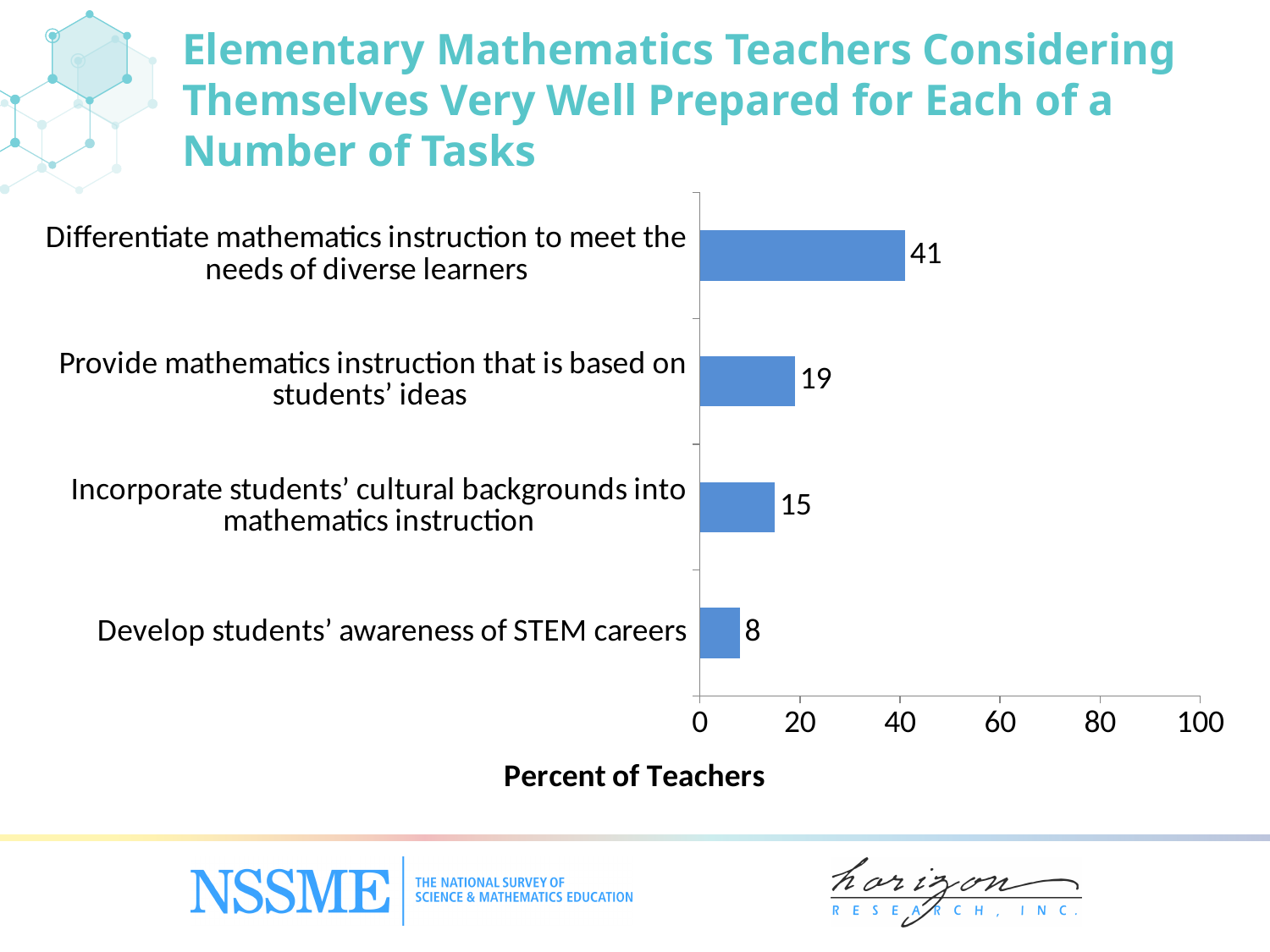
How many tasks are shown in the chart? 4 What is the difference between the value for differentiating mathematics instruction and the value for developing students' awareness of STEM careers? 33 Which task has the lowest percent of teachers considering themselves very well prepared? Develop students' awareness of STEM careers What is the value for incorporating students' cultural backgrounds into mathematics instruction? 15 What is the label of the horizontal axis? Percent of Teachers Which task has the highest percent of teachers considering themselves very well prepared? Differentiate mathematics instruction to meet the needs of diverse learners What is the difference between the value for providing instruction based on students' ideas and the value for incorporating students' cultural backgrounds? 4 What percent of teachers consider themselves very well prepared to provide mathematics instruction that is based on students' ideas? 19 What is the value for developing students' awareness of STEM careers? 8 Which is larger: the value for providing mathematics instruction based on students' ideas or the value for incorporating students' cultural backgrounds into mathematics instruction? Provide mathematics instruction that is based on students' ideas What percent of teachers consider themselves very well prepared to differentiate mathematics instruction to meet the needs of diverse learners? 41 What kind of chart is shown on the slide? Bar chart